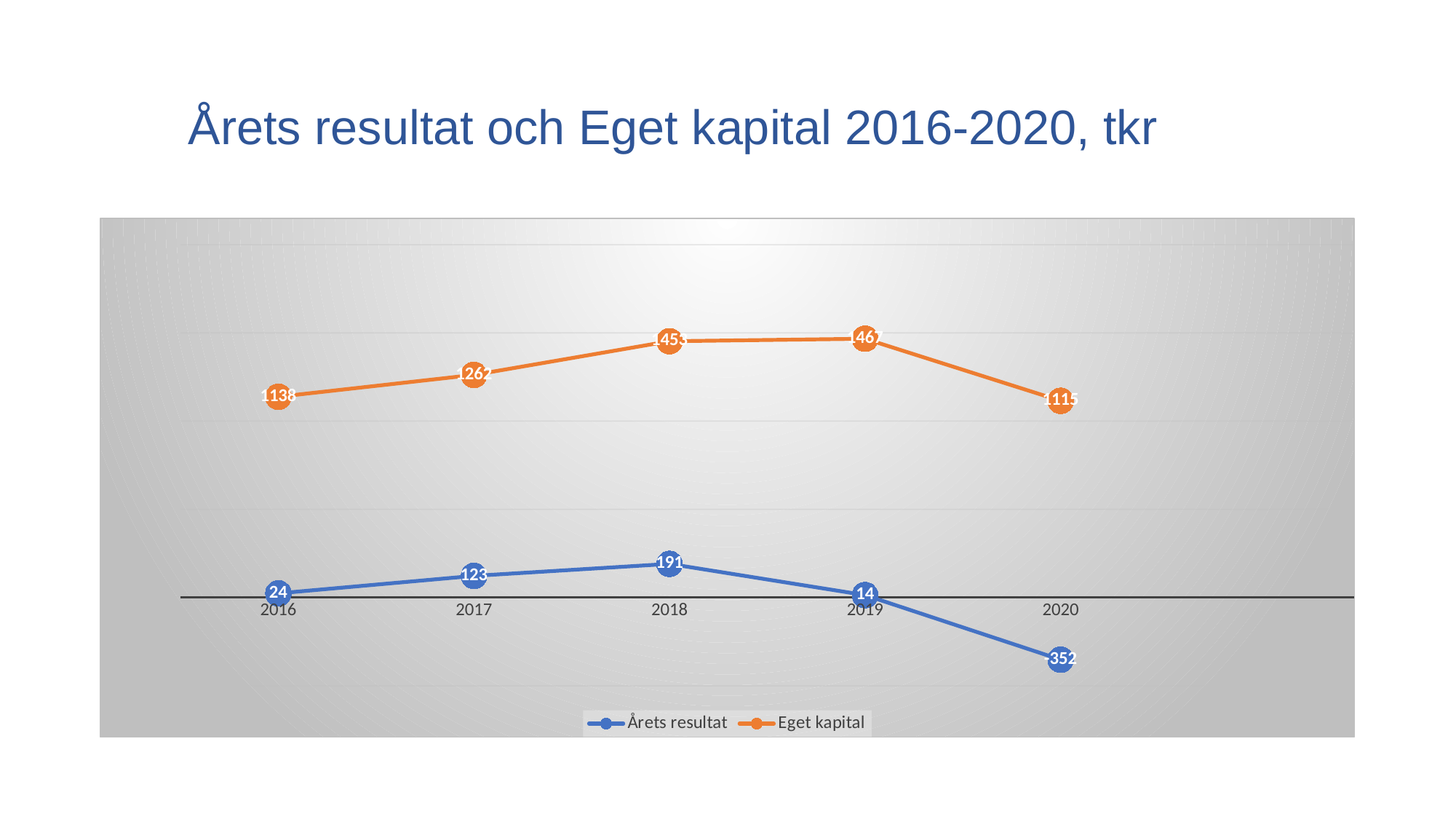
In which year is Årets resultat highest? 2018 How many series does the legend list? 2 In which year is Årets resultat lowest? 2020 What is the value of Årets resultat in 2018? 191 Which is larger, Årets resultat in 2017 or in 2019? 2017 What is the value of Årets resultat in 2019? 14 What is the value of Eget kapital in 2016? 1138 How many years are shown on the x axis? 5 What is the difference between Eget kapital in 2017 and in 2016? 124 In which year is Eget kapital highest? 2019 What is the value of Eget kapital in 2020? 1115 In which year is Eget kapital lowest? 2020